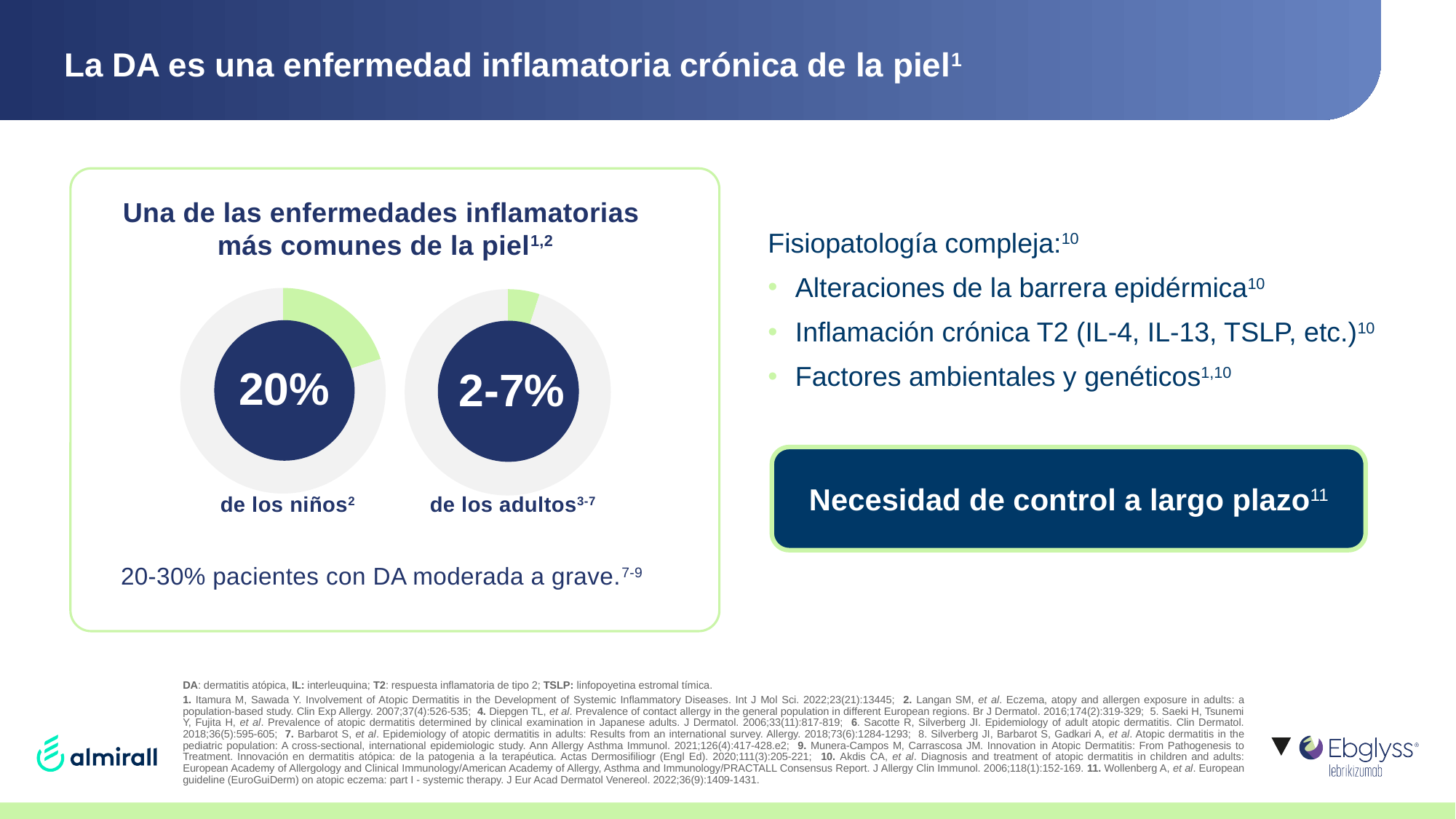
In the left donut chart, what share of the ring is highlighted in green for 'de los niños'? 20% What percentage is shown in the left donut chart for 'de los niños'? 20% What is the heading above the two donut charts? Una de las enfermedades inflamatorias más comunes de la piel Is the highlighted share for 'de los adultos' greater or less than 10%? less What colour is the highlighted slice in the donut charts? Light green What kind of charts are used to show the 20% and 2-7% figures? Donut (pie) charts Which group has the larger highlighted share, 'de los niños' or 'de los adultos'? de los niños How many donut charts are shown on the slide? 2 What value is shown in the right donut chart for 'de los adultos'? 2-7%